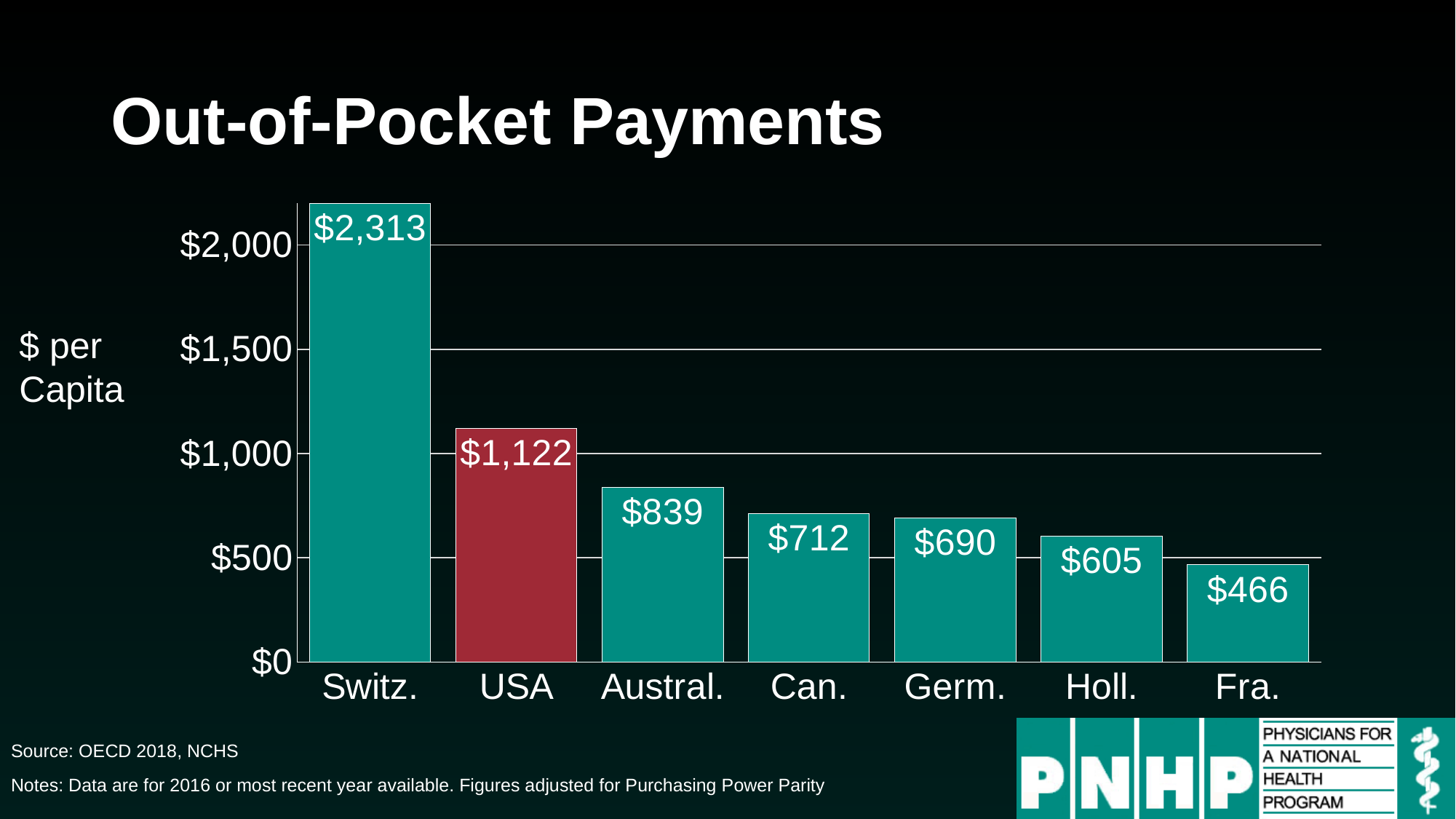
What is the difference between the values for Austral. and Can.? $127 Which country has the lowest out-of-pocket payments per capita? Fra. What is the out-of-pocket payment per capita for the USA? $1,122 Which has a larger value, Holl. or Fra.? Holl. Which bar is coloured differently (red) from the others? USA What is the difference between the values for Switz. and the USA? $1,191 Is the value for the USA greater or less than $1,000? greater What is the out-of-pocket payment per capita for Switz.? $2,313 What kind of chart is shown on the slide? Bar chart How many countries are shown in the chart? 7 Which country has the highest out-of-pocket payments per capita? Switz. What is the value shown for Germ.? $690